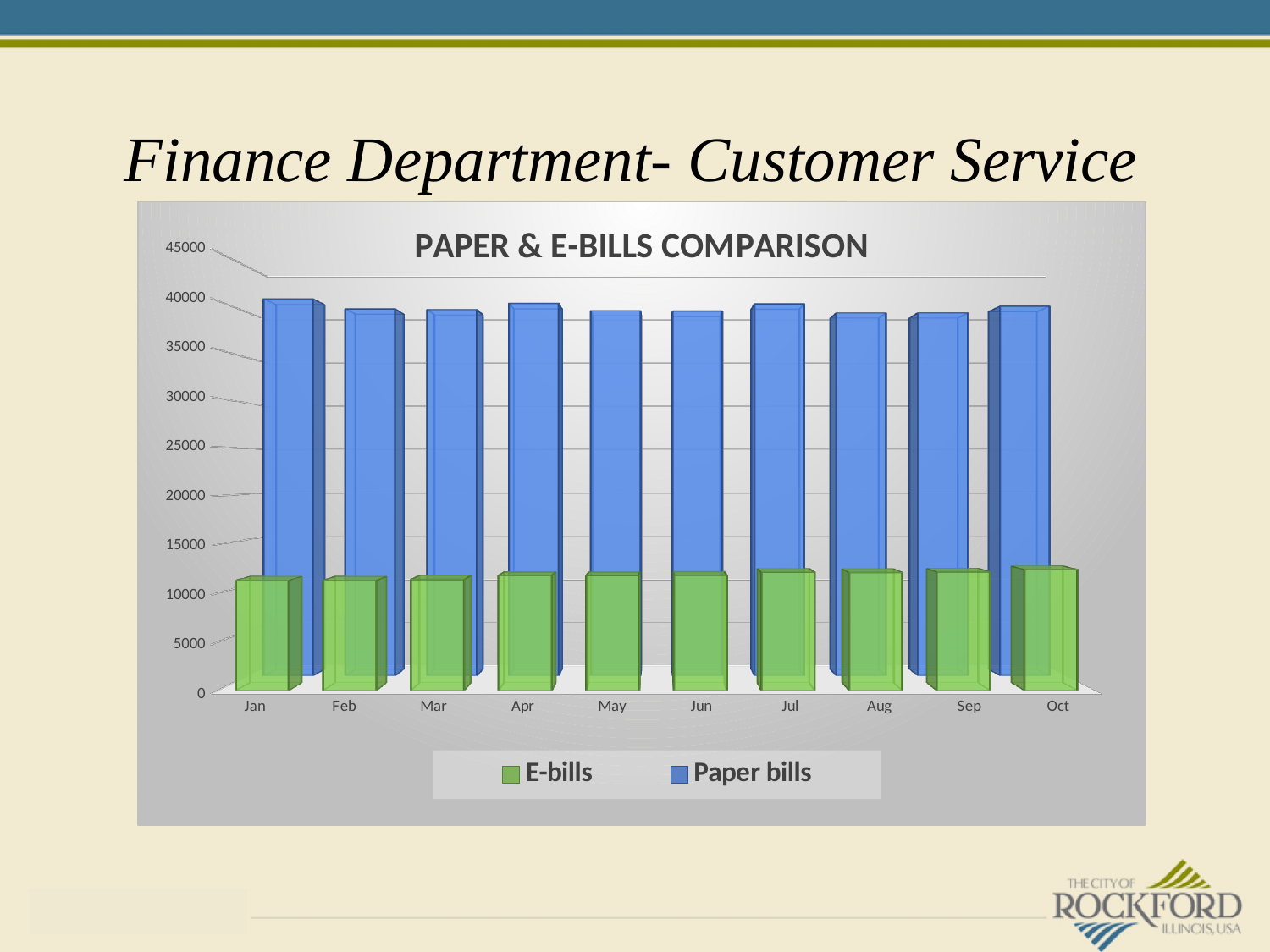
Which colour represents E-bills in the chart? green Which month has the highest value for E-bills? Oct Is the value for Paper bills in Feb greater or less than 45000? less Is the value for E-bills in Jan greater or less than 15000? less Is the value for Paper bills in Jan greater or less than 35000? greater What kind of chart is shown on the slide? bar chart Do the E-bills values generally rise or fall from Jan to Oct? rise How many months are shown on the x axis of the chart? 10 In May, which is larger: Paper bills or E-bills? Paper bills What is the title of the chart? PAPER & E-BILLS COMPARISON How many series does the legend list? 2